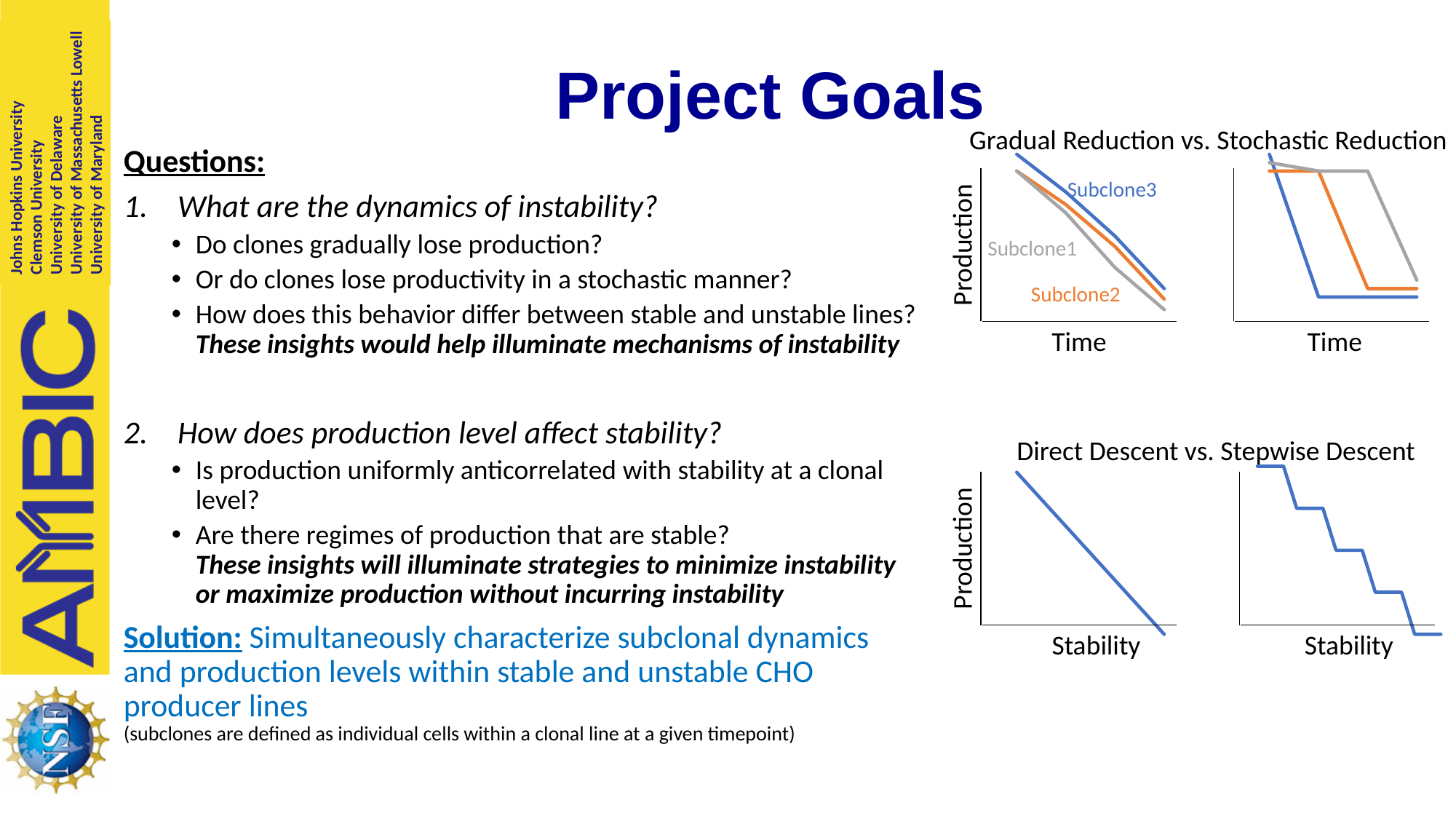
How many lines are plotted in the Stochastic Reduction chart? 3 In the Stochastic Reduction chart, do the lines rise or fall over Time? fall What is the x-axis label of the Gradual Reduction chart? Time In the Gradual Reduction chart, do the lines rise or fall along the Time axis? fall In the Stepwise Descent chart, does the line rise or fall along the Stability axis? fall What kind of chart is the Direct Descent chart? line chart What kind of chart is the Gradual Reduction chart? line chart How many lines are plotted in the Stepwise Descent chart? 1 What is the x-axis label of the Direct Descent chart? Stability How many subclone lines are plotted in the Gradual Reduction chart? 3